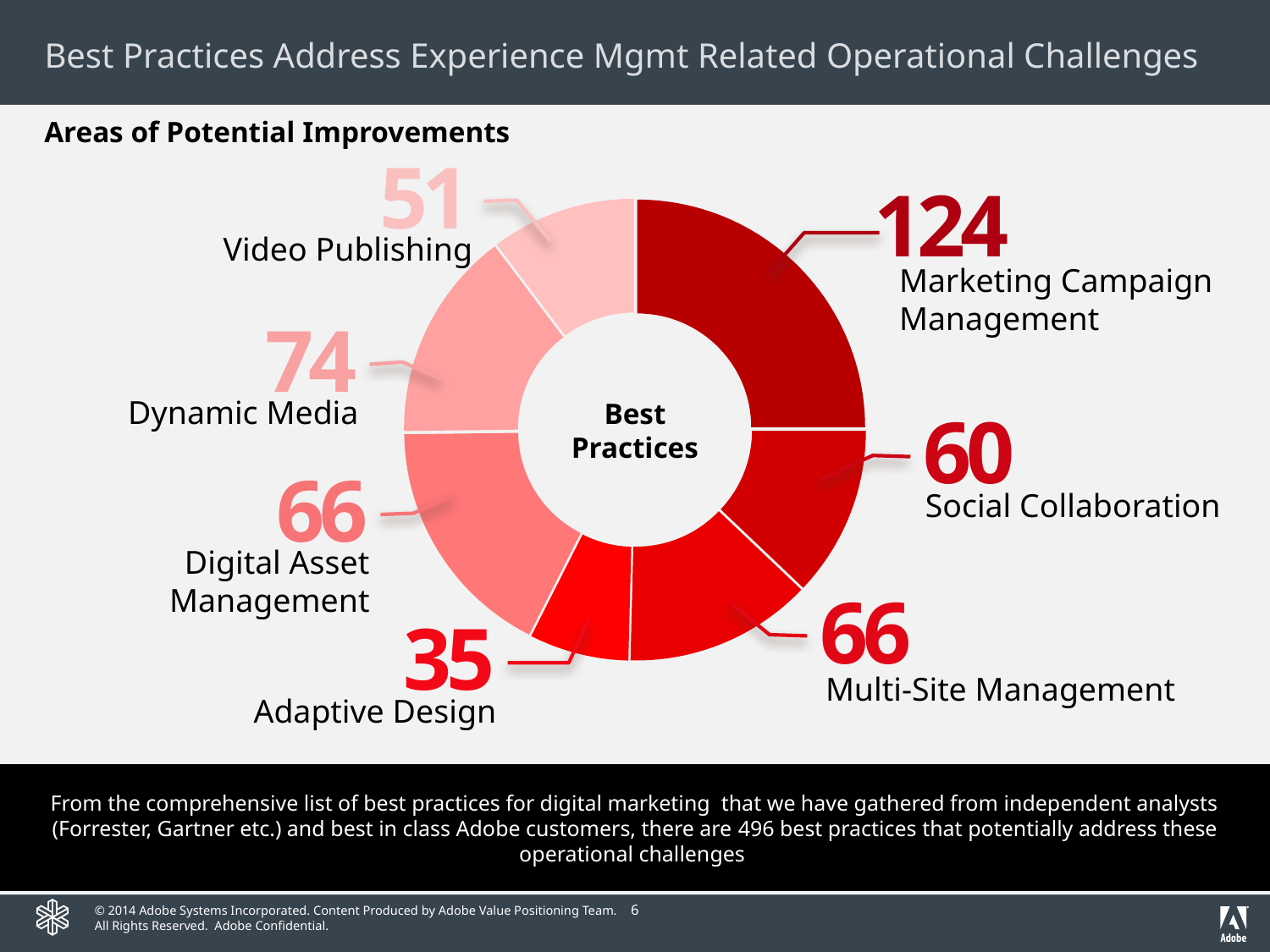
Which category has the lowest value? Adaptive Design What is the difference between the values for Marketing Campaign Management and Social Collaboration? 64 What is the value for Marketing Campaign Management? 124 What is the value for Video Publishing? 51 What is the value for Adaptive Design? 35 Which is larger, the value for Dynamic Media or the value for Social Collaboration? Dynamic Media What is the difference between the values for Dynamic Media and Video Publishing? 23 What kind of chart is shown on the slide? Donut chart What is the value for Social Collaboration? 60 Which category has the highest value? Marketing Campaign Management How many categories are shown in the chart? 7 What is the value for Dynamic Media? 74